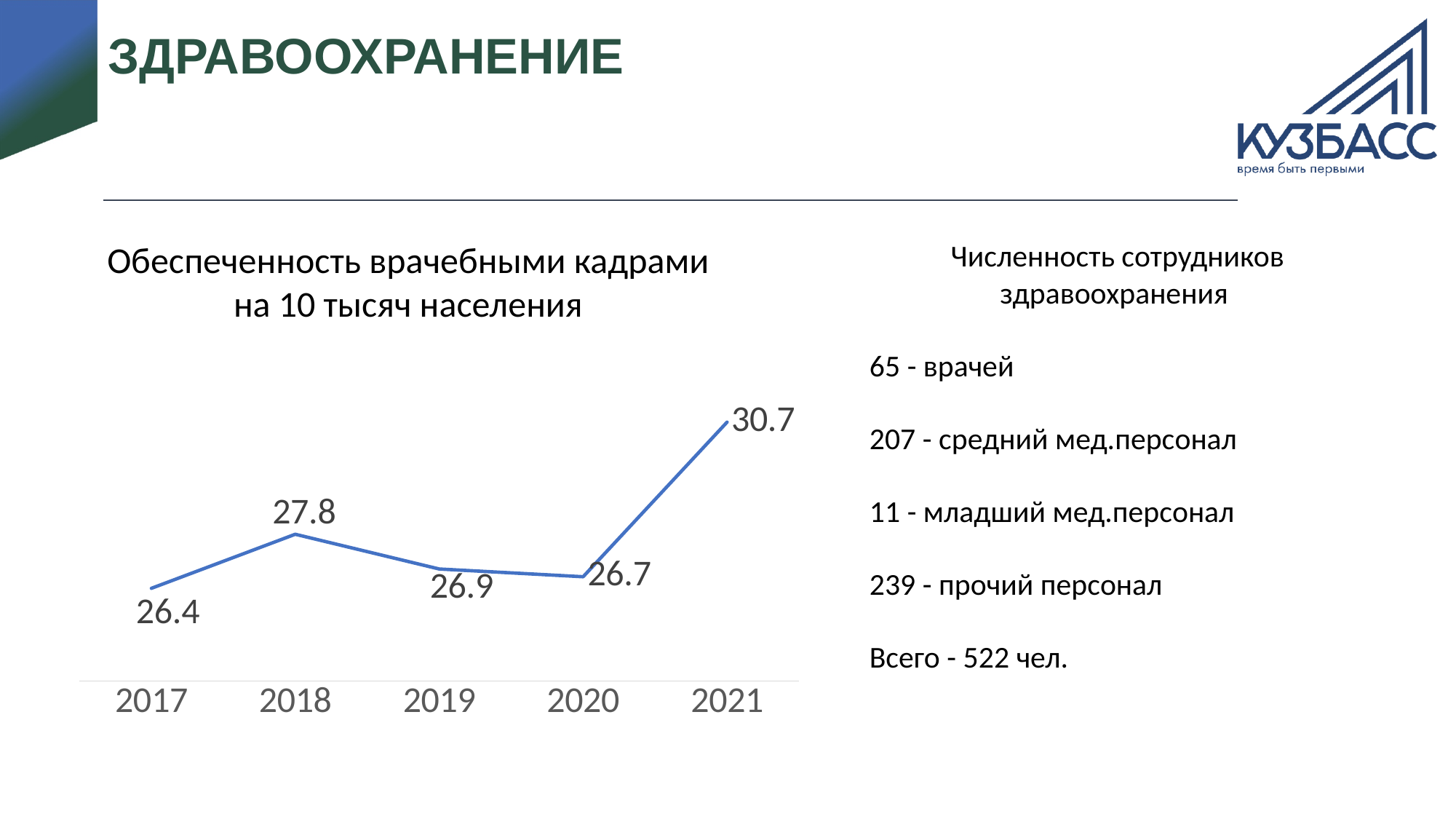
What is the value for 2020 on the chart? 26.7 What is the value for 2018 on the chart? 27.8 What is the value for 2017 on the chart? 26.4 Which year has the larger value, 2018 or 2019? 2018 What is the value for 2021 on the chart? 30.7 What is the difference between the values for 2021 and 2020? 4.0 Which year has the highest value on the chart? 2021 What is the value for 2019 on the chart? 26.9 Which year has the lowest value on the chart? 2017 How many years are plotted on the chart? 5 What is the difference between the values for 2018 and 2017? 1.4 What type of chart is shown on the slide? Line chart